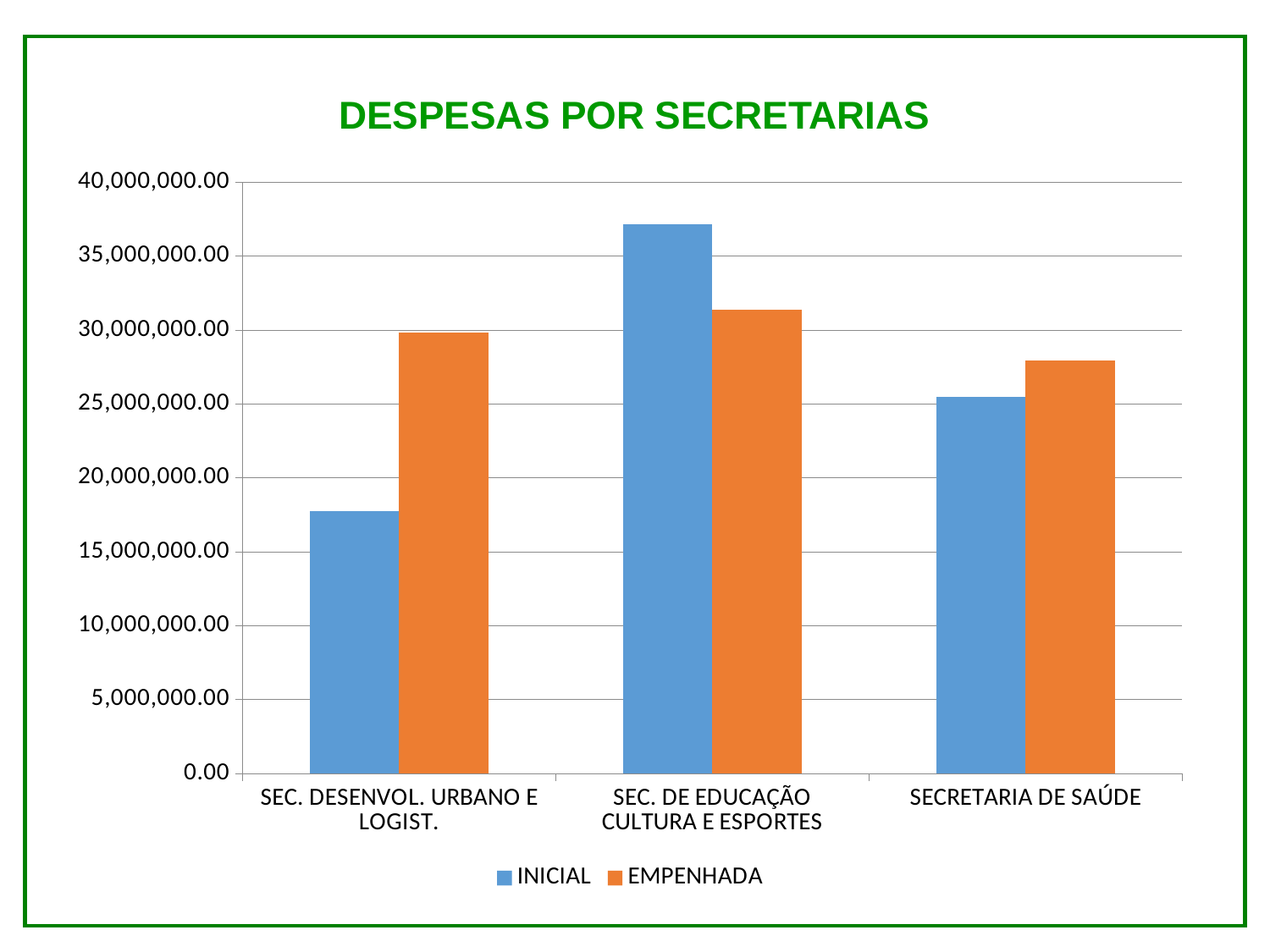
For SEC. DE EDUCAÇÃO CULTURA E ESPORTES, which is larger: INICIAL or EMPENHADA? INICIAL How many series does the legend list? 2 What is the title of the chart? DESPESAS POR SECRETARIAS Is the INICIAL value for SEC. DE EDUCAÇÃO CULTURA E ESPORTES greater or less than 35,000,000.00? greater What type of chart is shown on the slide? bar chart Is the INICIAL value for SEC. DESENVOL. URBANO E LOGIST. greater or less than 20,000,000.00? less How many categories are shown on the x axis? 3 Which category has the highest INICIAL value? SEC. DE EDUCAÇÃO CULTURA E ESPORTES For SEC. DESENVOL. URBANO E LOGIST., which is larger: INICIAL or EMPENHADA? EMPENHADA Which category has the highest EMPENHADA value? SEC. DE EDUCAÇÃO CULTURA E ESPORTES Which category has the lowest INICIAL value? SEC. DESENVOL. URBANO E LOGIST. Is the EMPENHADA value for SECRETARIA DE SAÚDE greater or less than 30,000,000.00? less